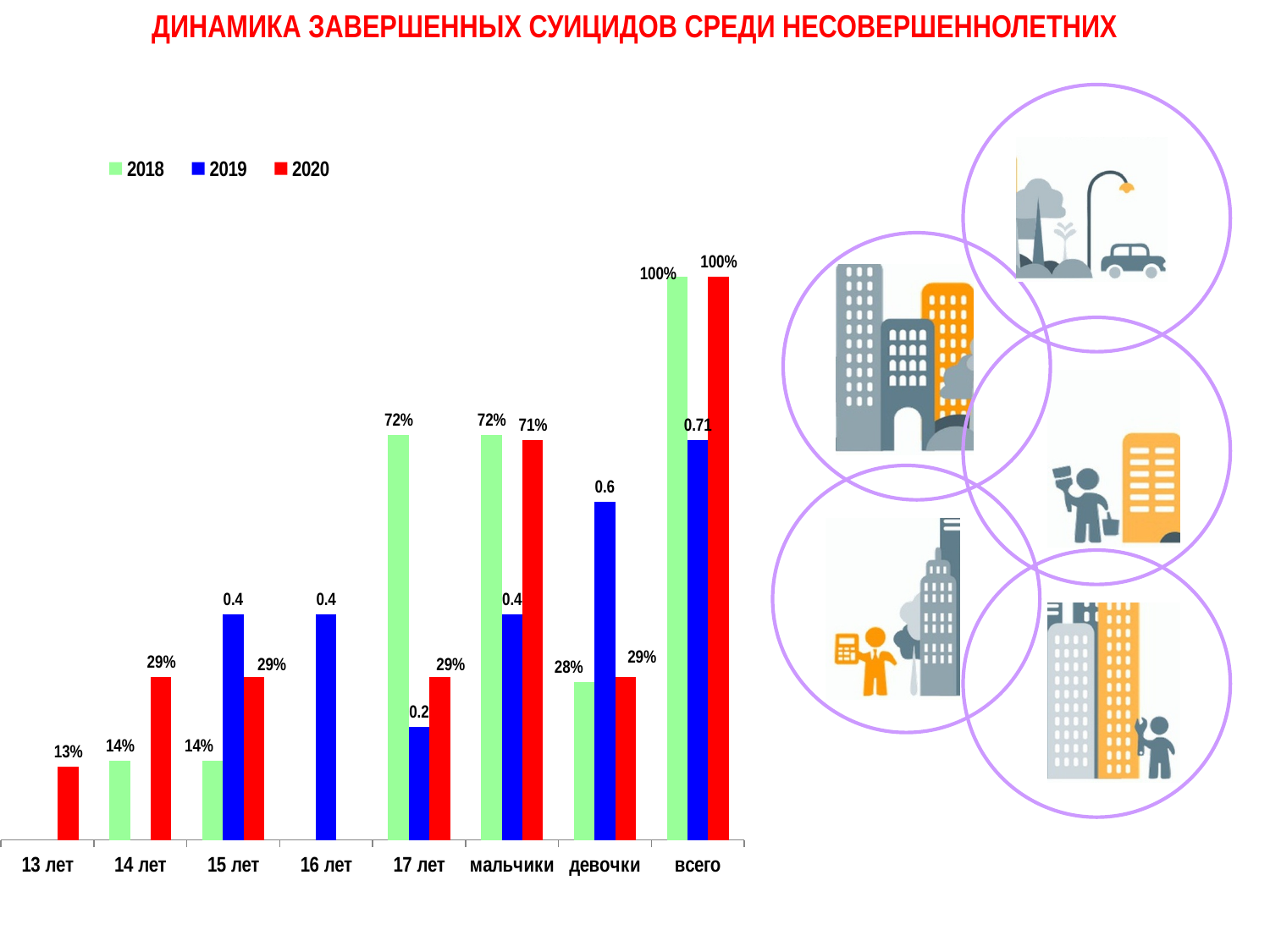
What is the difference between the 2018 and 2020 values for 17 лет? 43% What is the value for 2019 in the девочки category? 0.6 Which category has the lowest value for the 2020 series? 13 лет Which is larger for the 2019 series: the value for девочки or the value for мальчики? девочки How many series does the legend list? 3 What is the value for 2018 in the 17 лет category? 72% What is the difference between the 2020 values for мальчики and девочки? 42% Which category has the lowest value for the 2019 series? 17 лет What is the value for 2020 in the 13 лет category? 13% What is the value for 2019 in the всего category? 0.71 How many categories are shown on the x axis? 8 What type of chart is shown on the slide? bar chart